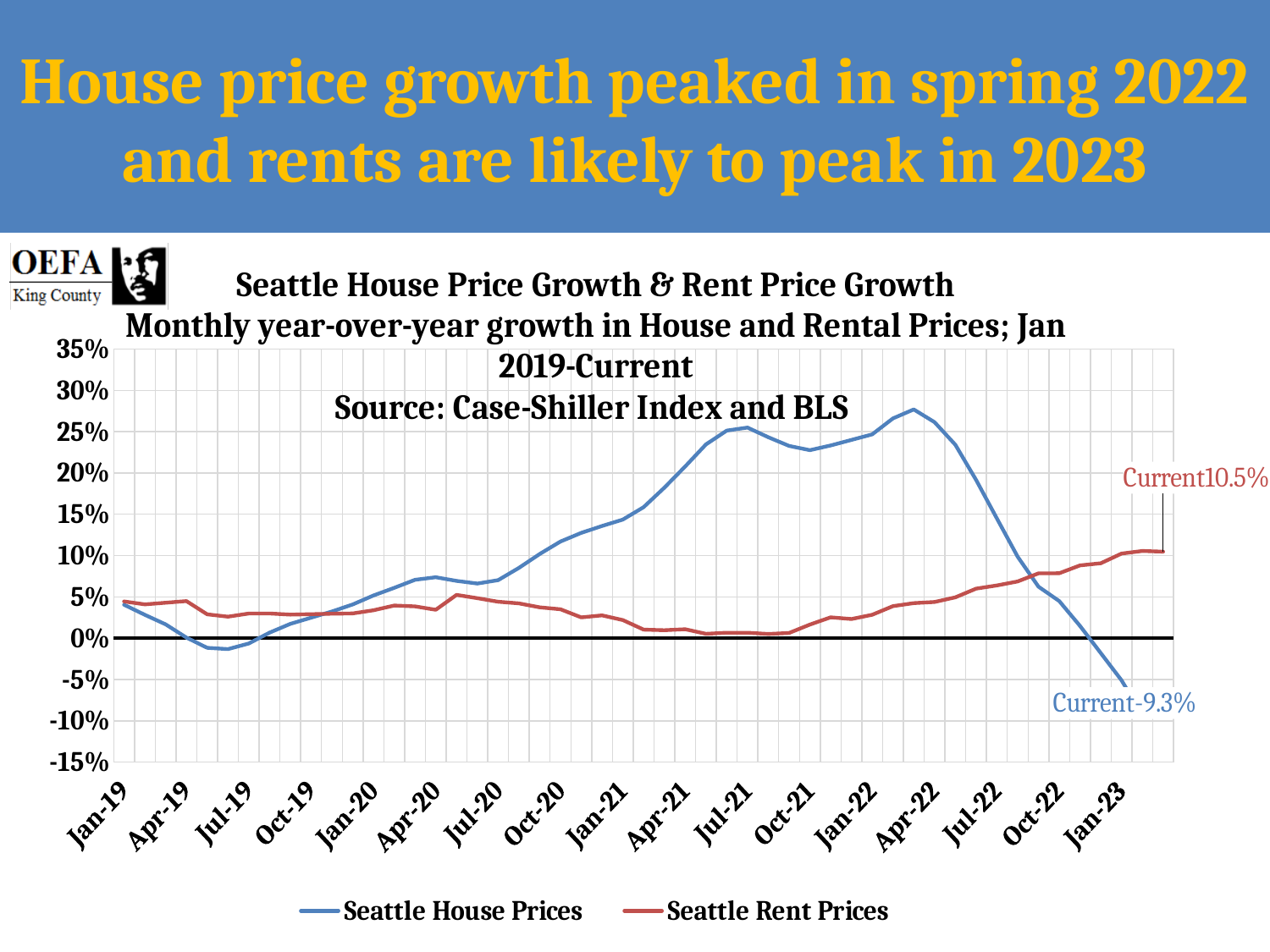
What kind of chart is shown on the slide? Line chart Which series has the higher current value, Seattle House Prices or Seattle Rent Prices? Seattle Rent Prices Is the value for Seattle Rent Prices at Jul-21 greater or less than 5%? less What source is cited in the chart title? Case-Shiller Index and BLS Which series reaches the highest peak on the chart? Seattle House Prices Is the value for Seattle House Prices at Apr-22 greater or less than 25%? greater Do Seattle House Prices rise or fall between Apr-22 and Jan-23? Fall How many series does the legend list? 2 What is the difference between the current Seattle Rent Prices value (10.5%) and the current Seattle House Prices value (-9.3%)? 19.8 percentage points What is the current value labelled for Seattle House Prices? -9.3% What is the current value labelled for Seattle Rent Prices? 10.5% Do Seattle Rent Prices rise or fall between Jul-21 and Jan-23? Rise